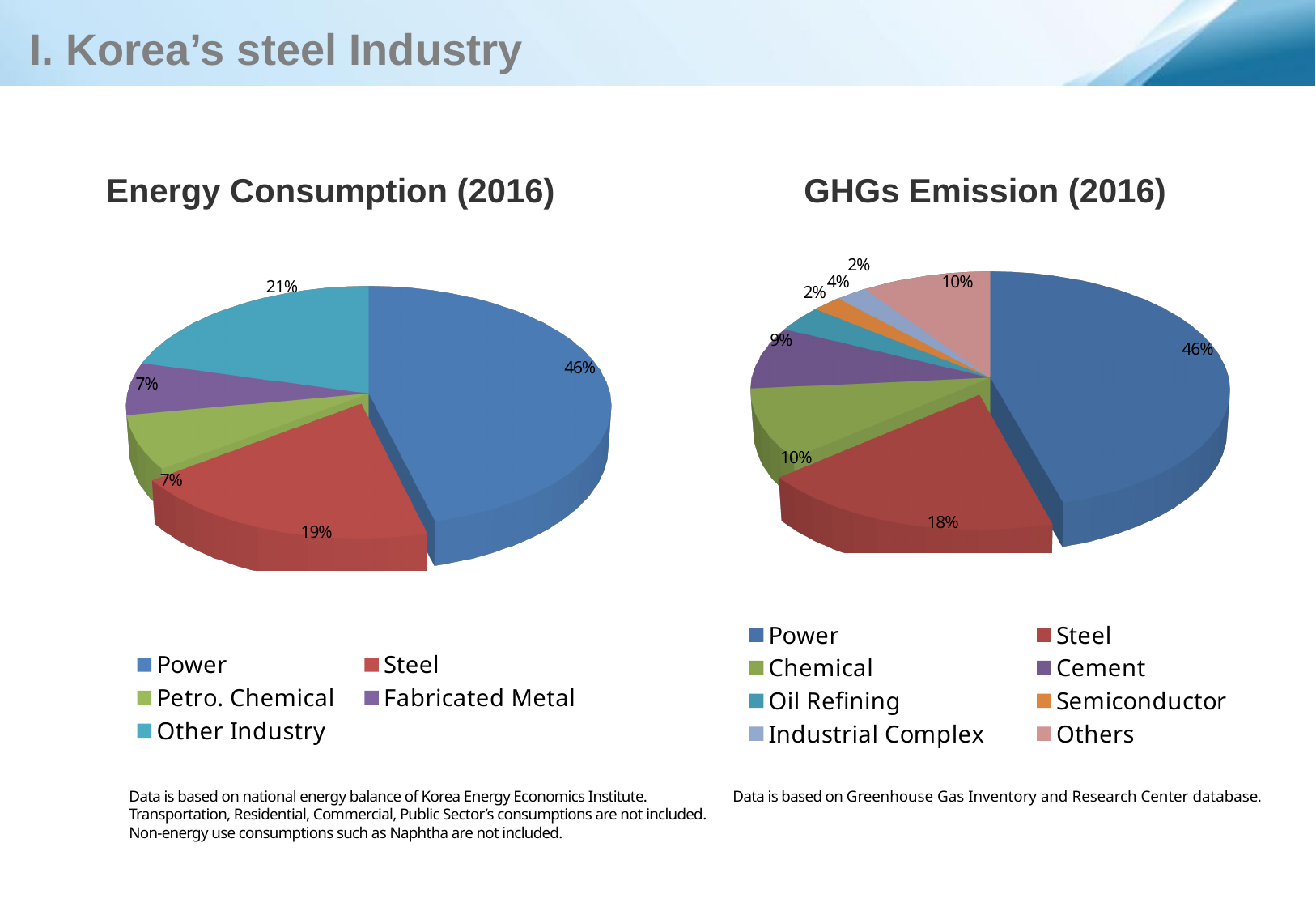
In the Energy Consumption (2016) chart, what share does Power have? 46% In the Energy Consumption (2016) chart, what share does Steel have? 19% In the Energy Consumption (2016) chart, what is the difference between the shares of Power and Steel? 27% What type of chart is used for GHGs Emission (2016)? Pie chart In the GHGs Emission (2016) chart, which category has the largest share? Power In the GHGs Emission (2016) chart, what share does Steel have? 18% In the Energy Consumption (2016) chart, what share does Other Industry have? 21% In the GHGs Emission (2016) chart, how many categories does the legend list? 8 In the Energy Consumption (2016) chart, how many categories does the legend list? 5 In the GHGs Emission (2016) chart, what share does Industrial Complex have? 2% In the Energy Consumption (2016) chart, which category has the largest share? Power In the GHGs Emission (2016) chart, what share does Cement have? 9%